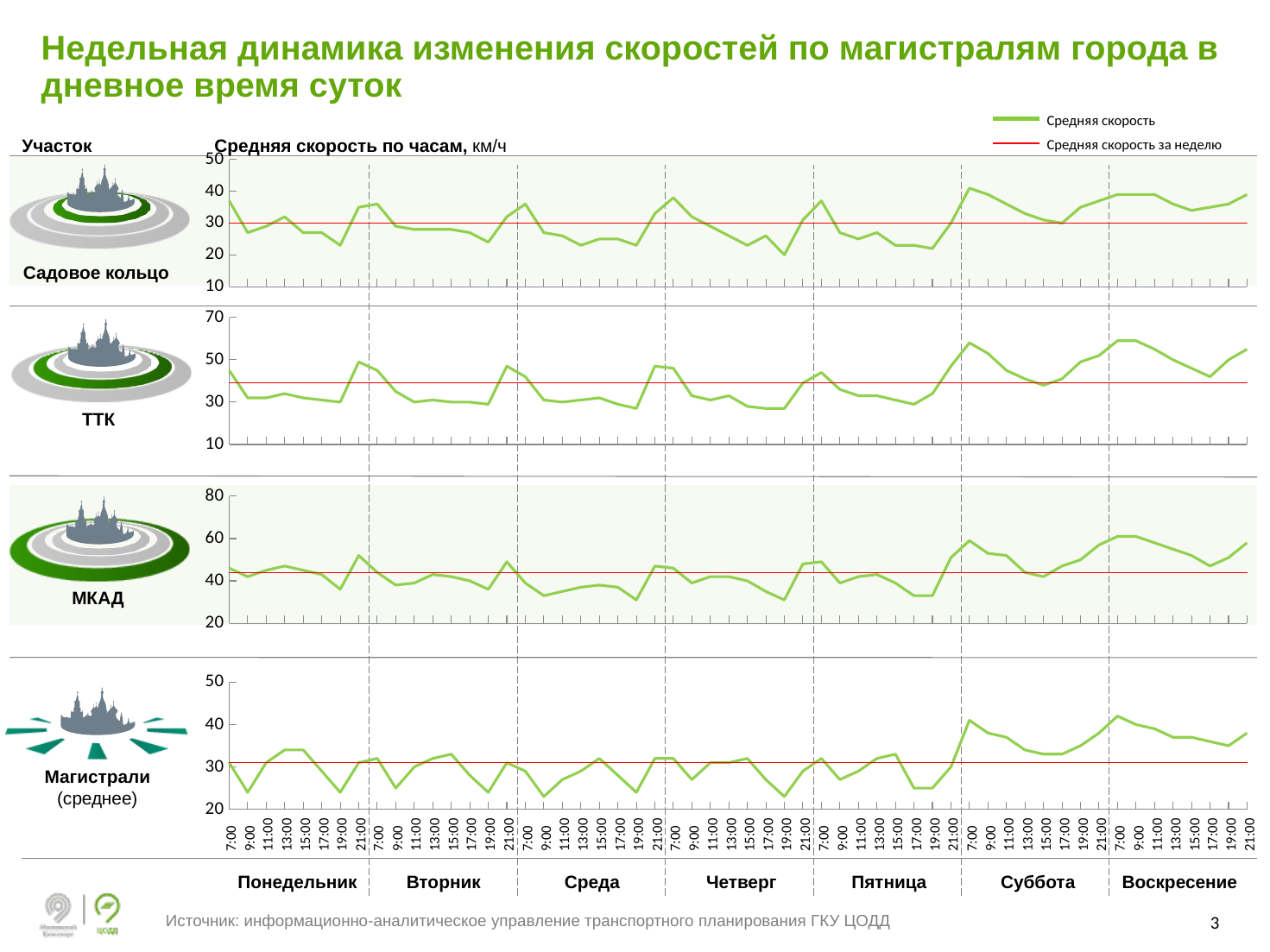
What kind of chart is used for the Садовое кольцо panel? line chart In the Садовое кольцо chart, is the value at 19:00 on Четверг greater or less than 30? less In the МКАД chart, is the value at 19:00 on Четверг greater or less than 40? less How many series does the legend list? 2 How many days of the week are shown along the x axis? 7 In the ТТК chart, is the value at 9:00 on Воскресение greater or less than 50? greater How many road sections (panels) are plotted on the slide? 4 In the ТТК chart, which is higher: the value at 7:00 on Понедельник or at 7:00 on Суббота? 7:00 on Суббота What does the red line in the charts represent according to the legend? Средняя скорость за неделю In the Садовое кольцо chart, does the line rise or fall from 7:00 to 17:00 on Суббота? fall